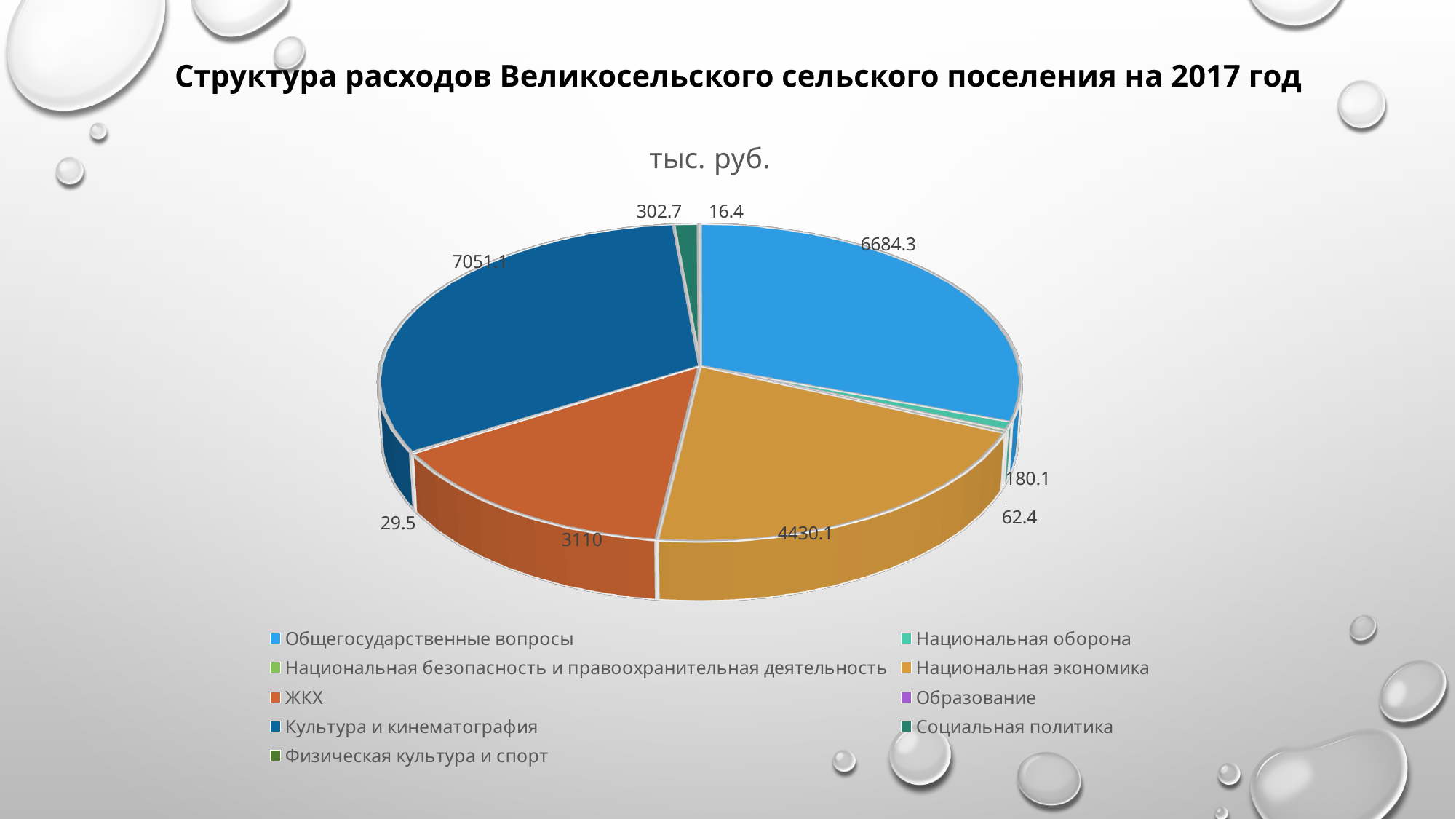
What is the difference between the values for Культура и кинематография and Общегосударственные вопросы? 366.8 How many categories does the legend list? 9 What is the value for Национальная экономика? 4430.1 Which is larger, the value for Национальная экономика or the value for ЖКХ? Национальная экономика What is the value for Социальная политика? 302.7 Which category has the largest slice of the pie? Культура и кинематография What is the value for Культура и кинематография? 7051.1 What is the value for Общегосударственные вопросы? 6684.3 What unit is given in the chart title? тыс. руб. What is the value for ЖКХ? 3110 What kind of chart is shown on the slide? pie chart What is the difference between the values for Национальная экономика and ЖКХ? 1320.1